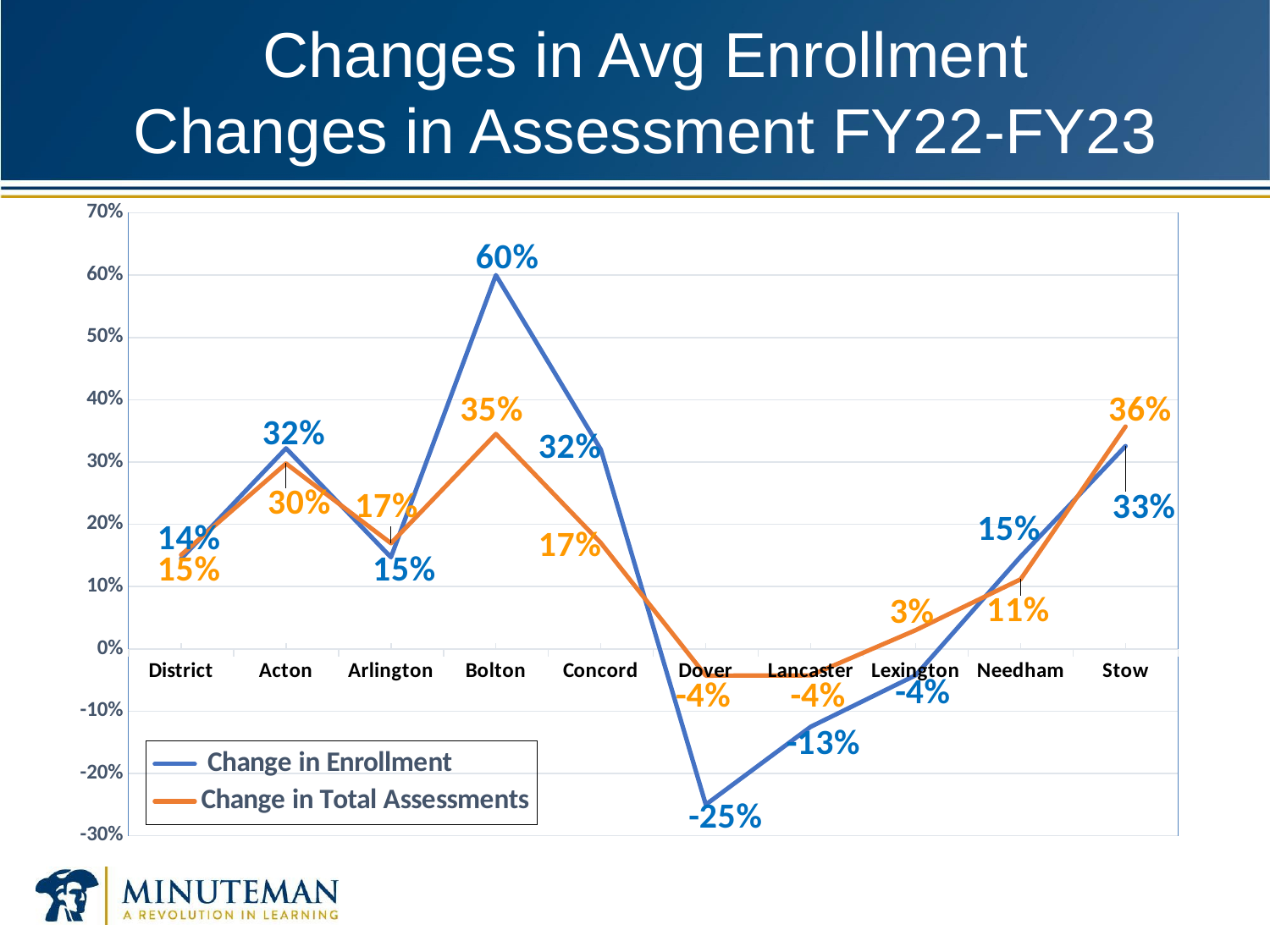
What is the Change in Enrollment value for Dover? -25% Which category has the highest Change in Total Assessments? Stow What is the Change in Enrollment value for Bolton? 60% How many categories are shown on the x axis? 10 What type of chart is shown on the slide? line chart What is the Change in Total Assessments value for Lexington? 3% How many series does the legend list? 2 Which category has the highest Change in Enrollment? Bolton Which category has the lowest Change in Enrollment? Dover What is the difference between the Change in Enrollment and the Change in Total Assessments for Bolton? 25% What is the Change in Total Assessments value for Stow? 36% For Lancaster, which is larger: the Change in Enrollment or the Change in Total Assessments? Change in Total Assessments